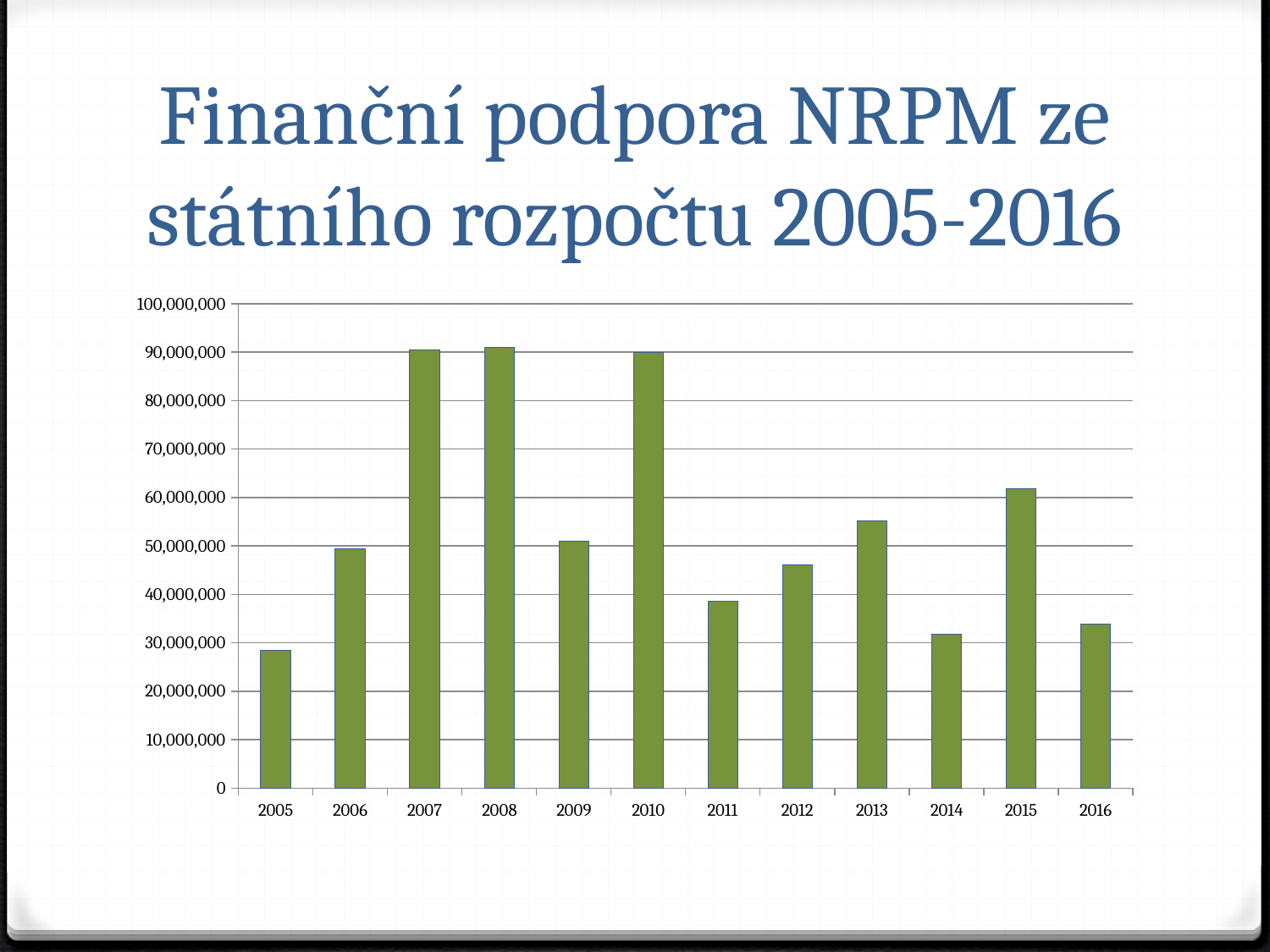
Do the values rise or fall from 2005 to 2008? rise Is the value for 2005 greater or less than 30,000,000? less Is the value for 2012 greater or less than 50,000,000? less What is the title of the slide containing the chart? Finanční podpora NRPM ze státního rozpočtu 2005-2016 Is the value for 2007 greater or less than 80,000,000? greater How many years are shown on the x axis of the chart? 12 Which year has the larger value, 2013 or 2015? 2015 Which year has the larger value, 2006 or 2012? 2006 Which year has the lowest value in the chart? 2005 What kind of chart is shown on the slide? bar chart